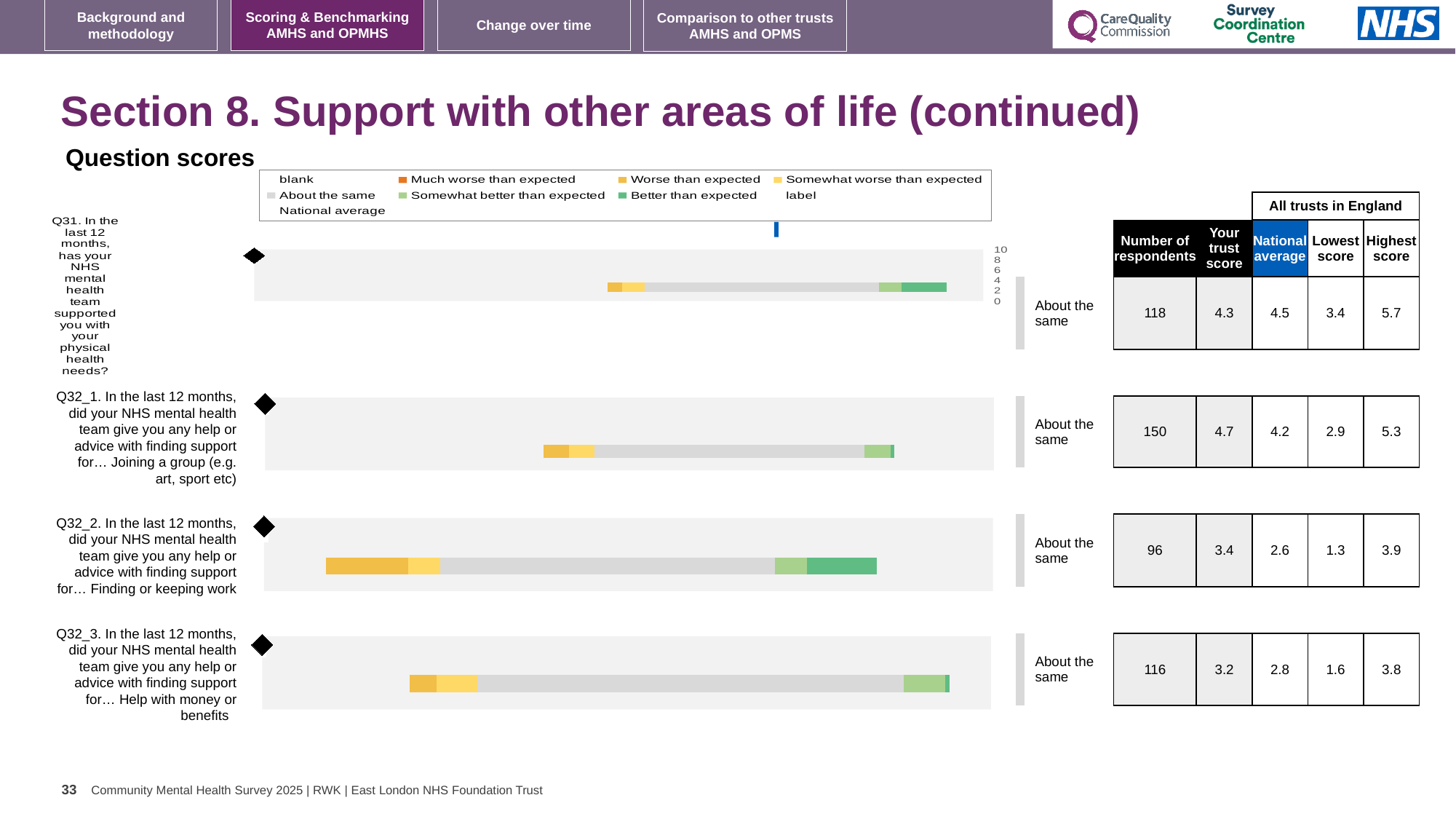
Which question has the highest 'Your trust score' on the slide? Q32_1 For the Q32_3 chart (help with money or benefits), what is the highest score among all trusts in England? 3.8 What kind of chart is used to show the question scores on this slide? Bar chart For the Q31 chart (physical health needs), what is the 'Your trust score' value? 4.3 What benchmark label is shown to the right of each of the four charts? About the same For the Q32_2 chart (finding or keeping work), what is the difference between the highest score and the lowest score? 2.6 For the Q32_1 chart (joining a group), what is the national average? 4.2 For the Q32_2 chart (finding or keeping work), how many respondents are there? 96 For the Q31 chart (physical health needs), which is larger: the trust score or the national average? National average How many entries does the legend above the charts list? 9 Which question has the lowest 'Your trust score' on the slide? Q32_3 How many question charts are shown on the slide? 4